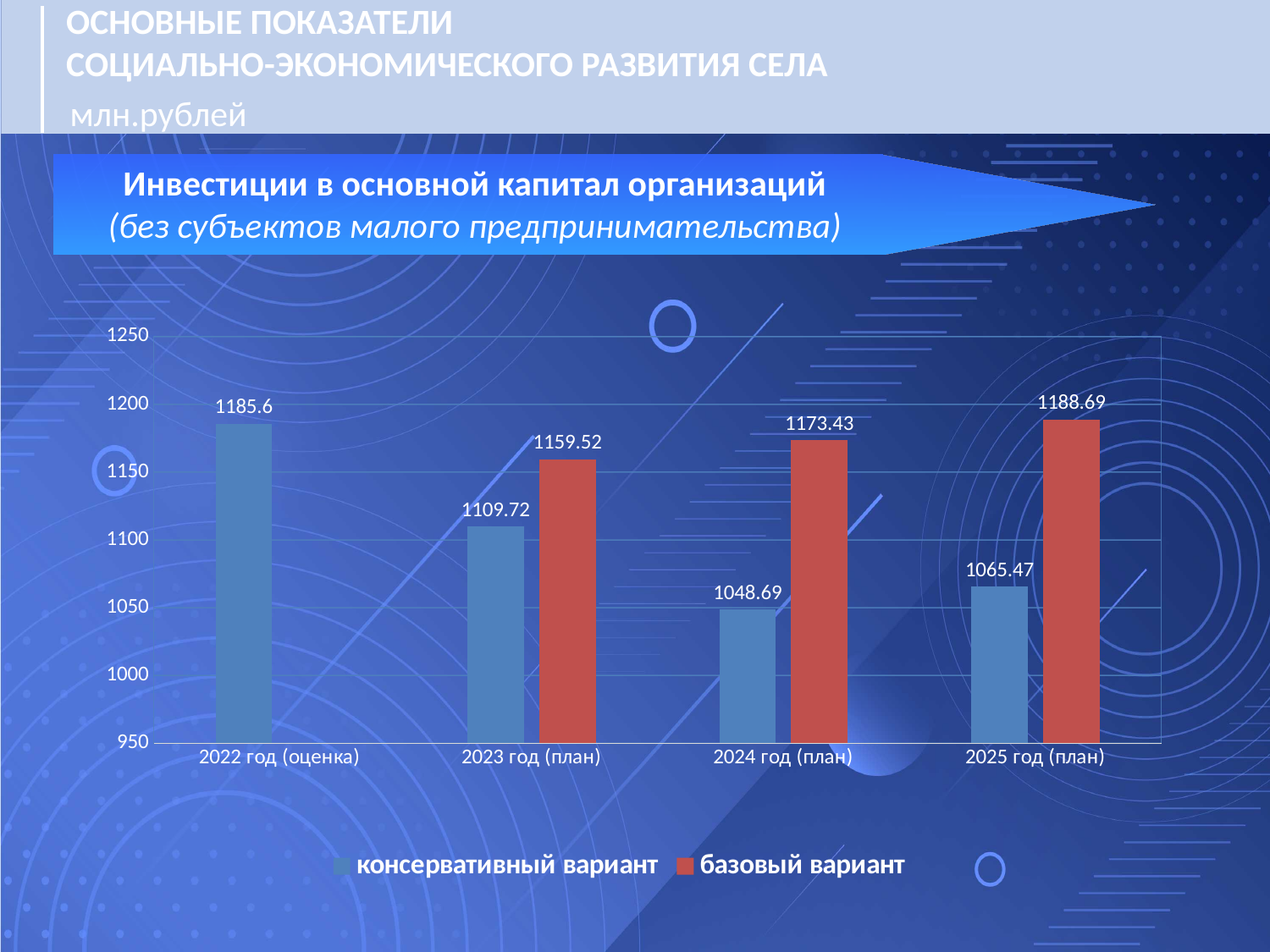
What is the value for консервативный вариант in 2025 год (план)? 1065.47 What is the value for базовый вариант in 2024 год (план)? 1173.43 How many series does the legend list? 2 Which is larger in 2024 год (план): консервативный вариант or базовый вариант? базовый вариант What kind of chart is shown on the slide? bar chart What is the difference between базовый вариант and консервативный вариант in 2023 год (план)? 49.8 Which year has the highest value for базовый вариант? 2025 год (план) Is the value for консервативный вариант in 2023 год (план) greater or less than 1100? greater Does the value for базовый вариант rise or fall from 2023 год (план) to 2025 год (план)? rise How many year categories are shown on the x axis? 4 What is the value for консервативный вариант in 2022 год (оценка)? 1185.6 Which year has the lowest value for консервативный вариант? 2024 год (план)